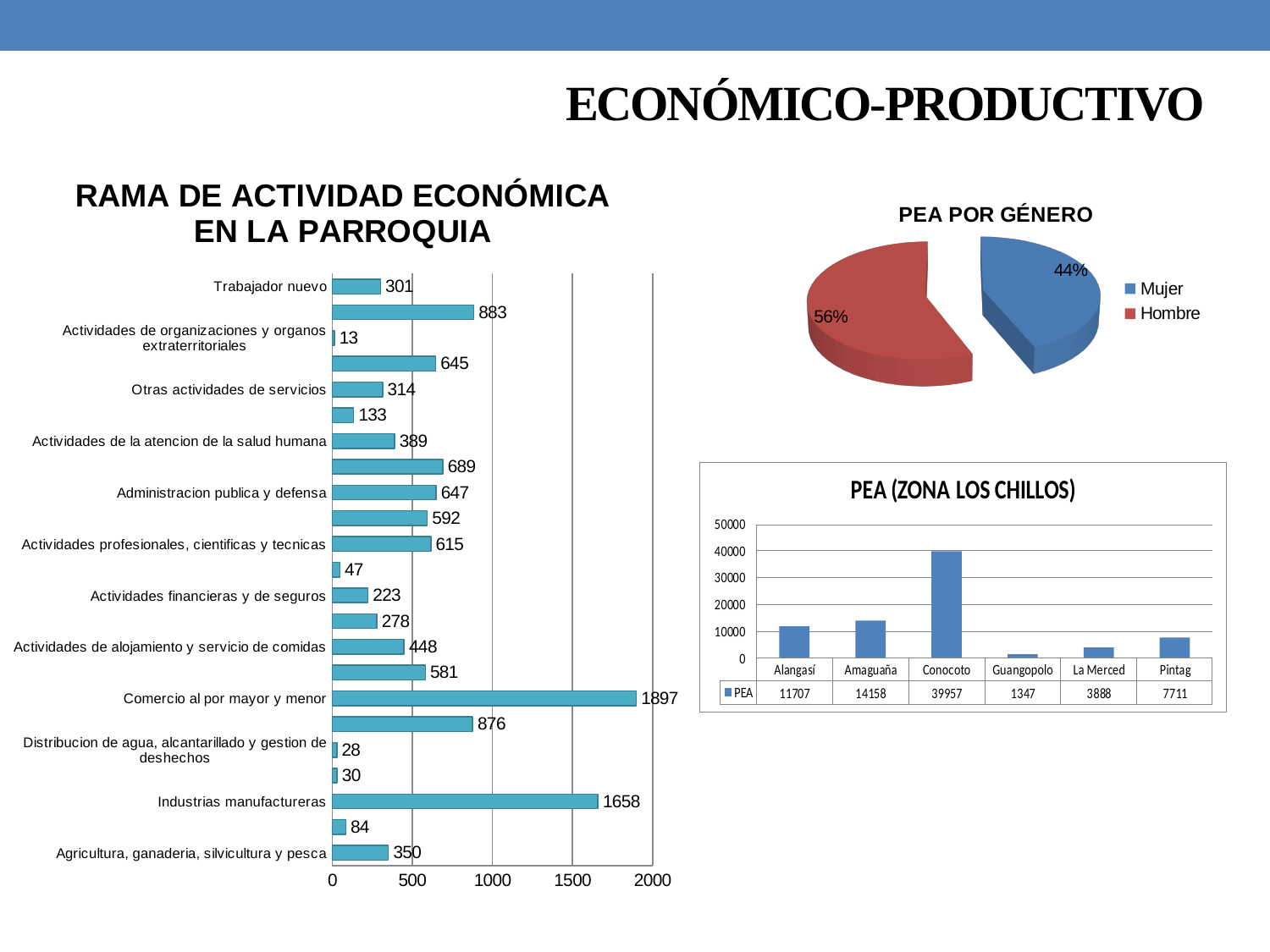
In the 'RAMA DE ACTIVIDAD ECONÓMICA EN LA PARROQUIA' chart, which labelled category has the highest value? Comercio al por mayor y menor In the 'RAMA DE ACTIVIDAD ECONÓMICA EN LA PARROQUIA' chart, what is the value for Comercio al por mayor y menor? 1897 In the 'PEA POR GÉNERO' pie chart, how many series does the legend list? 2 In the 'RAMA DE ACTIVIDAD ECONÓMICA EN LA PARROQUIA' chart, what is the value for Industrias manufactureras? 1658 In the 'PEA (ZONA LOS CHILLOS)' chart, which category has the lowest value? Guangopolo In the 'PEA POR GÉNERO' pie chart, what share is Hombre? 56% In the 'PEA (ZONA LOS CHILLOS)' chart, how many categories are shown? 6 In the 'RAMA DE ACTIVIDAD ECONÓMICA EN LA PARROQUIA' chart, which labelled category has the lowest value? Actividades de organizaciones y organos extraterritoriales In the 'RAMA DE ACTIVIDAD ECONÓMICA EN LA PARROQUIA' chart, what is the difference between Comercio al por mayor y menor and Industrias manufactureras? 239 In the 'PEA (ZONA LOS CHILLOS)' chart, what is the value for Conocoto? 39957 In the 'RAMA DE ACTIVIDAD ECONÓMICA EN LA PARROQUIA' chart, which is larger: Administracion publica y defensa or Actividades profesionales, cientificas y tecnicas? Administracion publica y defensa In the 'RAMA DE ACTIVIDAD ECONÓMICA EN LA PARROQUIA' chart, what type of chart is used? Bar chart